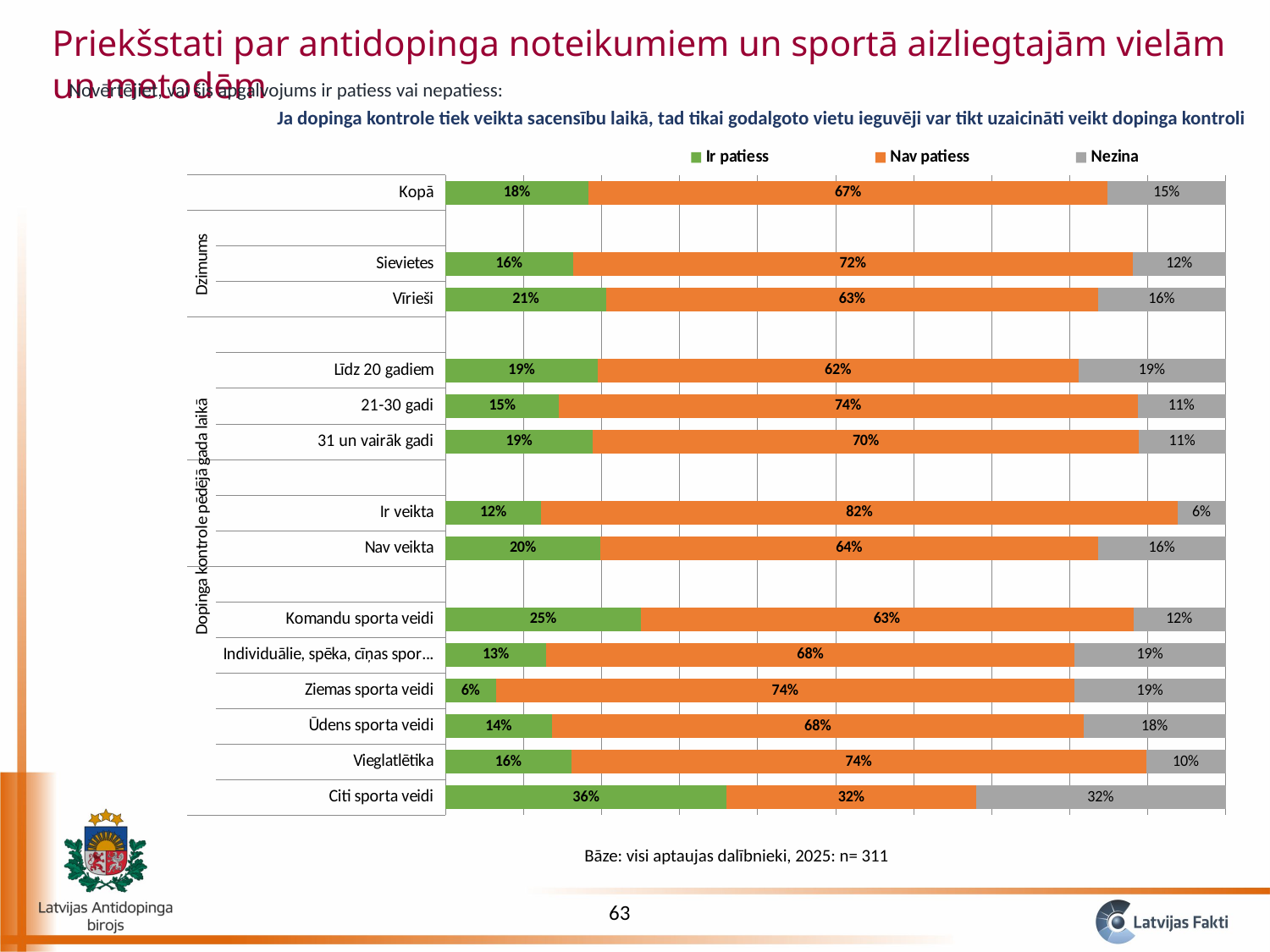
What kind of chart is shown on the slide? Stacked bar chart What is the "Nav patiess" value for Kopā? 67% What is the difference between the "Nav patiess" values for Sievietes and Vīrieši? 9% How many series does the legend list? 3 What is the "Ir patiess" value for Komandu sporta veidi? 25% Which category has the highest "Ir patiess" value? Citi sporta veidi Which category has the highest "Nav patiess" value? Ir veikta What is the "Nezina" value for Ir veikta? 6% How many categories are plotted in the chart? 14 What is the total of the stacked bar for Citi sporta veidi? 100% Which category has the lowest "Ir patiess" value? Ziemas sporta veidi Which has a larger "Nezina" value, Līdz 20 gadiem or 21-30 gadi? Līdz 20 gadiem